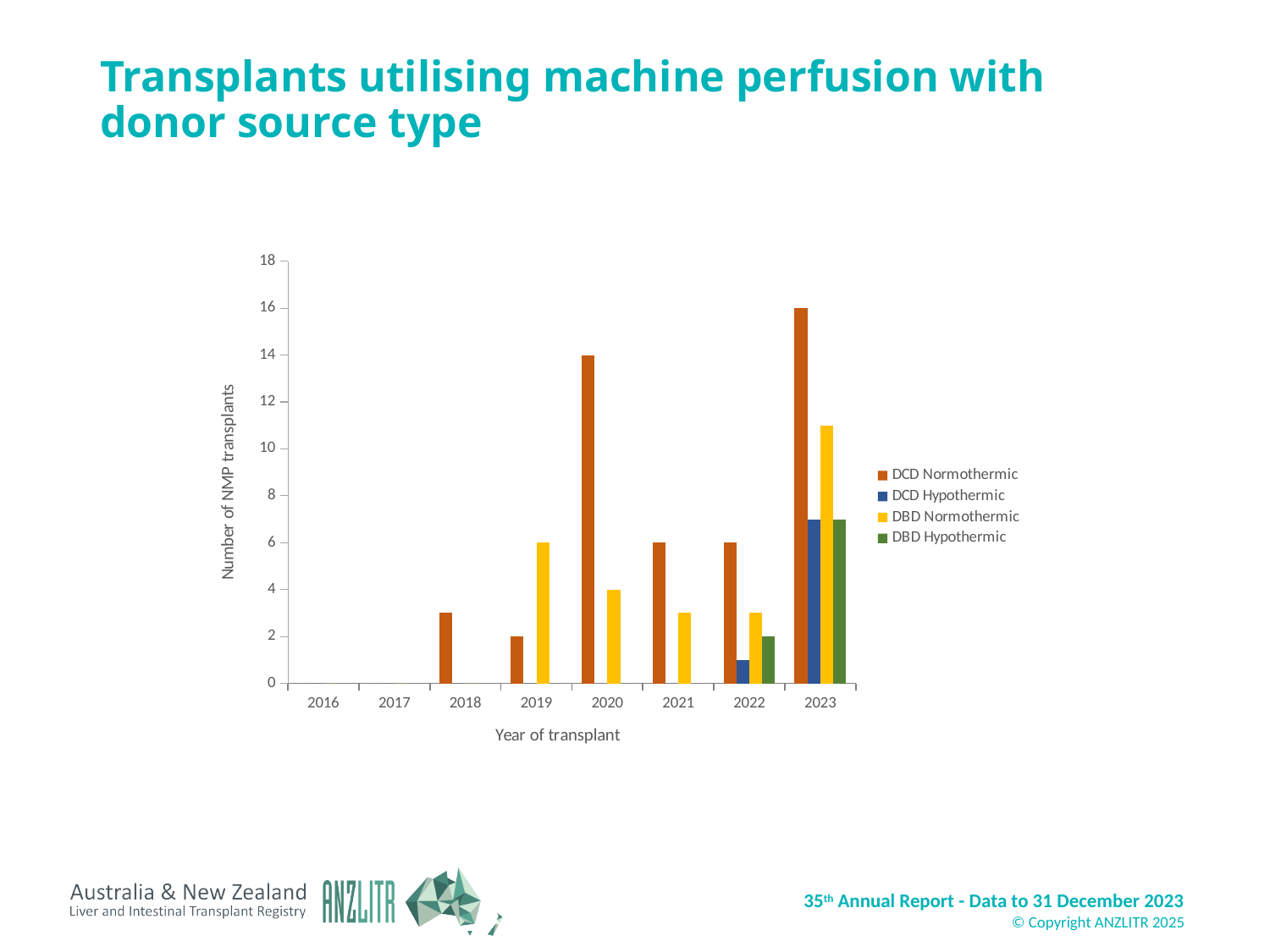
What is the value for DBD Normothermic in 2020? 4 What is the value for DCD Normothermic in 2020? 14 Is the value for DCD Hypothermic in 2022 greater or less than 2? less What is the value for DCD Normothermic in 2023? 16 Is the value for DBD Normothermic in 2023 greater or less than 10? greater Which is larger in 2023, DCD Normothermic or DBD Normothermic? DCD Normothermic What is the difference between the DCD Normothermic values in 2023 and 2020? 2 What kind of chart is shown on the slide? bar chart How many series does the legend list? 4 How many years are shown on the x axis? 8 What is the value for DBD Normothermic in 2019? 6 Which year has the highest DCD Normothermic value? 2023